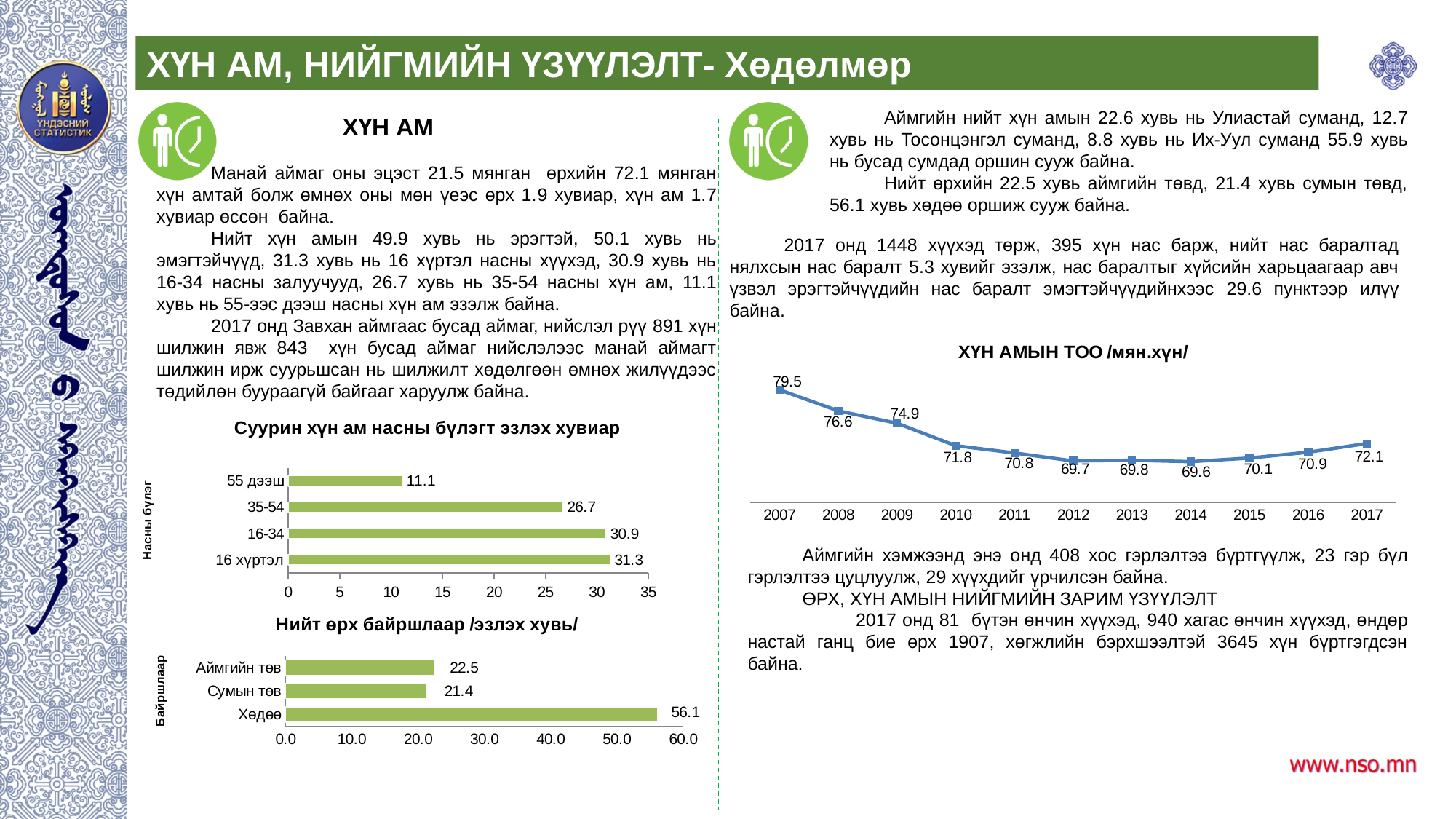
In the chart 'Нийт өрх байршлаар /эзлэх хувь/', what is the value for Хөдөө? 56.1 In the chart 'ХҮН АМЫН ТОО /мян.хүн/', what is the value for 2014? 69.6 In the chart 'Нийт өрх байршлаар /эзлэх хувь/', which category has the highest value? Хөдөө In the chart 'Суурин хүн ам насны бүлэгт эзлэх хувиар', what is the value for the 35-54 age group? 26.7 In the chart 'Суурин хүн ам насны бүлэгт эзлэх хувиар', what is the difference between the values for 16-34 and 55 дээш? 19.8 In the chart 'Суурин хүн ам насны бүлэгт эзлэх хувиар', how many age groups are shown? 4 In the chart 'ХҮН АМЫН ТОО /мян.хүн/', how many years are plotted? 11 In the chart 'Суурин хүн ам насны бүлэгт эзлэх хувиар', which age group has the lowest value? 55 дээш In the chart 'ХҮН АМЫН ТОО /мян.хүн/', what is the difference between the values for 2007 and 2017? 7.4 What kind of chart is 'Нийт өрх байршлаар /эзлэх хувь/'? Bar chart In the chart 'ХҮН АМЫН ТОО /мян.хүн/', which year has the highest value? 2007 In the chart 'Нийт өрх байршлаар /эзлэх хувь/', which is larger, Аймгийн төв or Сумын төв? Аймгийн төв